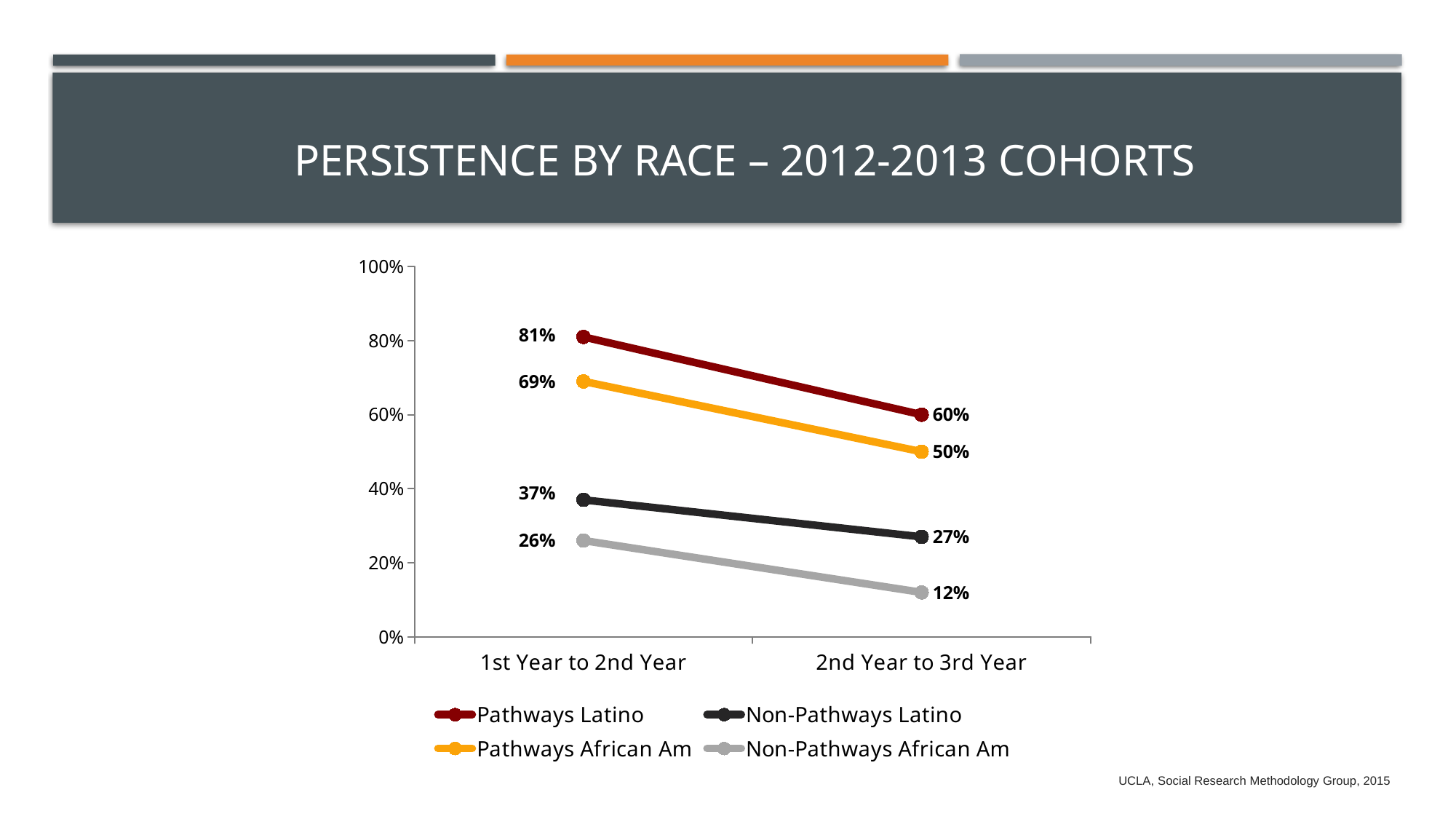
What kind of chart is shown on the slide? Line chart What is the difference between the Pathways Latino values at 1st Year to 2nd Year and 2nd Year to 3rd Year? 21 percentage points Which series has the lowest value at 2nd Year to 3rd Year? Non-Pathways African Am Which is larger at 2nd Year to 3rd Year: Pathways African Am or Non-Pathways Latino? Pathways African Am What is the title of the slide containing the chart? PERSISTENCE BY RACE – 2012-2013 COHORTS What is the value for Non-Pathways Latino at 1st Year to 2nd Year? 37% Do the values for Non-Pathways Latino rise or fall from 1st Year to 2nd Year to 2nd Year to 3rd Year? Fall What is the value for Pathways African Am at 2nd Year to 3rd Year? 50% How many series does the legend list? 4 What is the value for Pathways Latino at 1st Year to 2nd Year? 81% What is the value for Non-Pathways African Am at 2nd Year to 3rd Year? 12% Which series has the highest value at 1st Year to 2nd Year? Pathways Latino